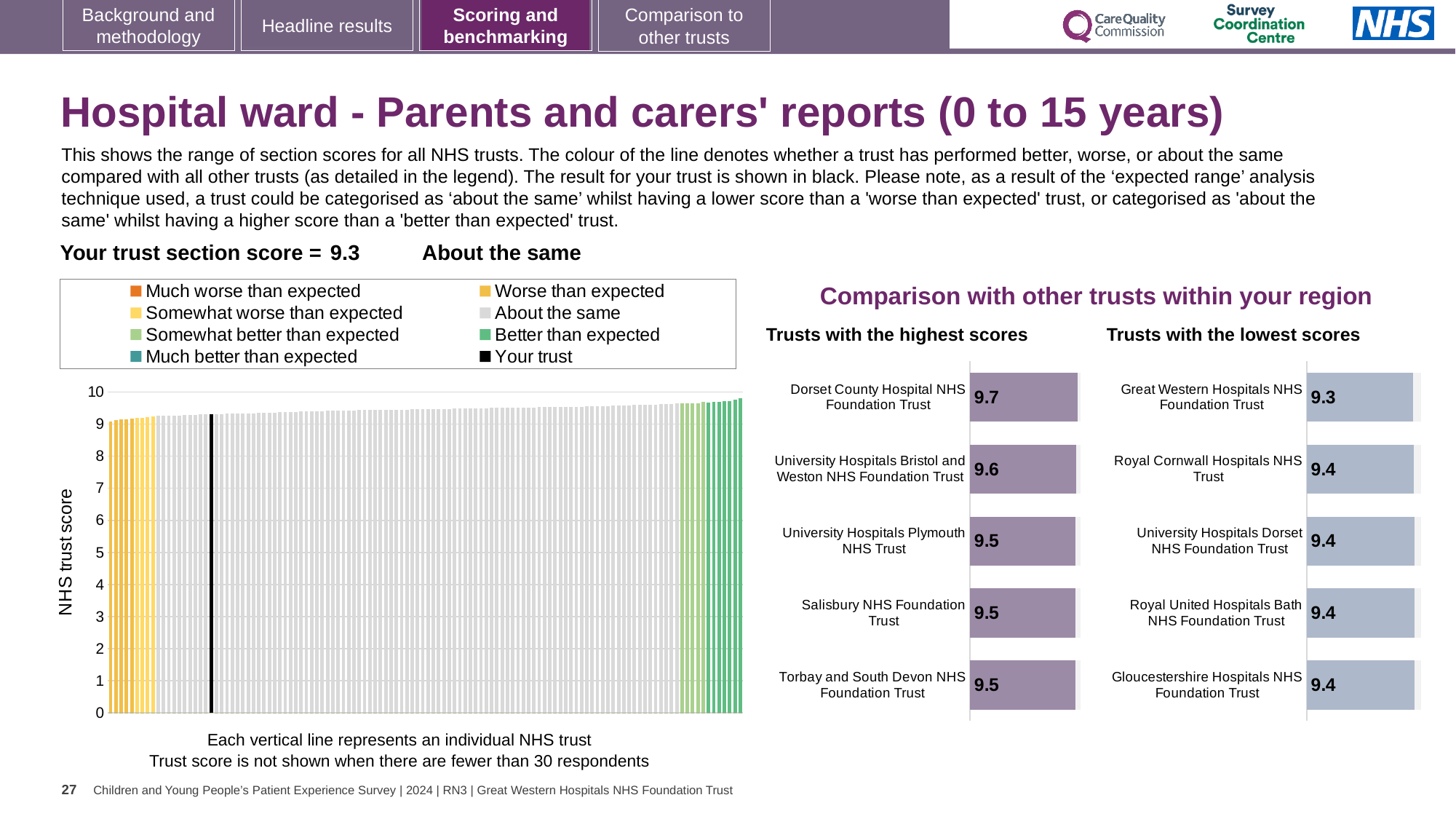
In the 'Trusts with the lowest scores' chart, what is the score for Great Western Hospitals NHS Foundation Trust? 9.3 In the 'Trusts with the highest scores' chart, which trust has the highest score? Dorset County Hospital NHS Foundation Trust What kind of chart is the large chart on the left of the slide showing NHS trust scores? Bar chart In the 'Trusts with the highest scores' chart, what is the score for University Hospitals Bristol and Weston NHS Foundation Trust? 9.6 In the 'Trusts with the lowest scores' chart, what is the score for Royal Cornwall Hospitals NHS Trust? 9.4 In the 'Trusts with the lowest scores' chart, which trust has the lowest score? Great Western Hospitals NHS Foundation Trust In the 'Trusts with the highest scores' chart, what is the difference between the scores of Dorset County Hospital NHS Foundation Trust and Salisbury NHS Foundation Trust? 0.2 In the large chart on the left, do the bar values rise or fall from left to right along the x axis? Rise In the 'Trusts with the highest scores' chart, which has the larger score: Dorset County Hospital NHS Foundation Trust or University Hospitals Plymouth NHS Trust? Dorset County Hospital NHS Foundation Trust How many trusts are listed in the 'Trusts with the lowest scores' chart? 5 In the 'Trusts with the highest scores' chart, what is the score for Dorset County Hospital NHS Foundation Trust? 9.7 How many entries does the legend above the large chart on the left list? 8